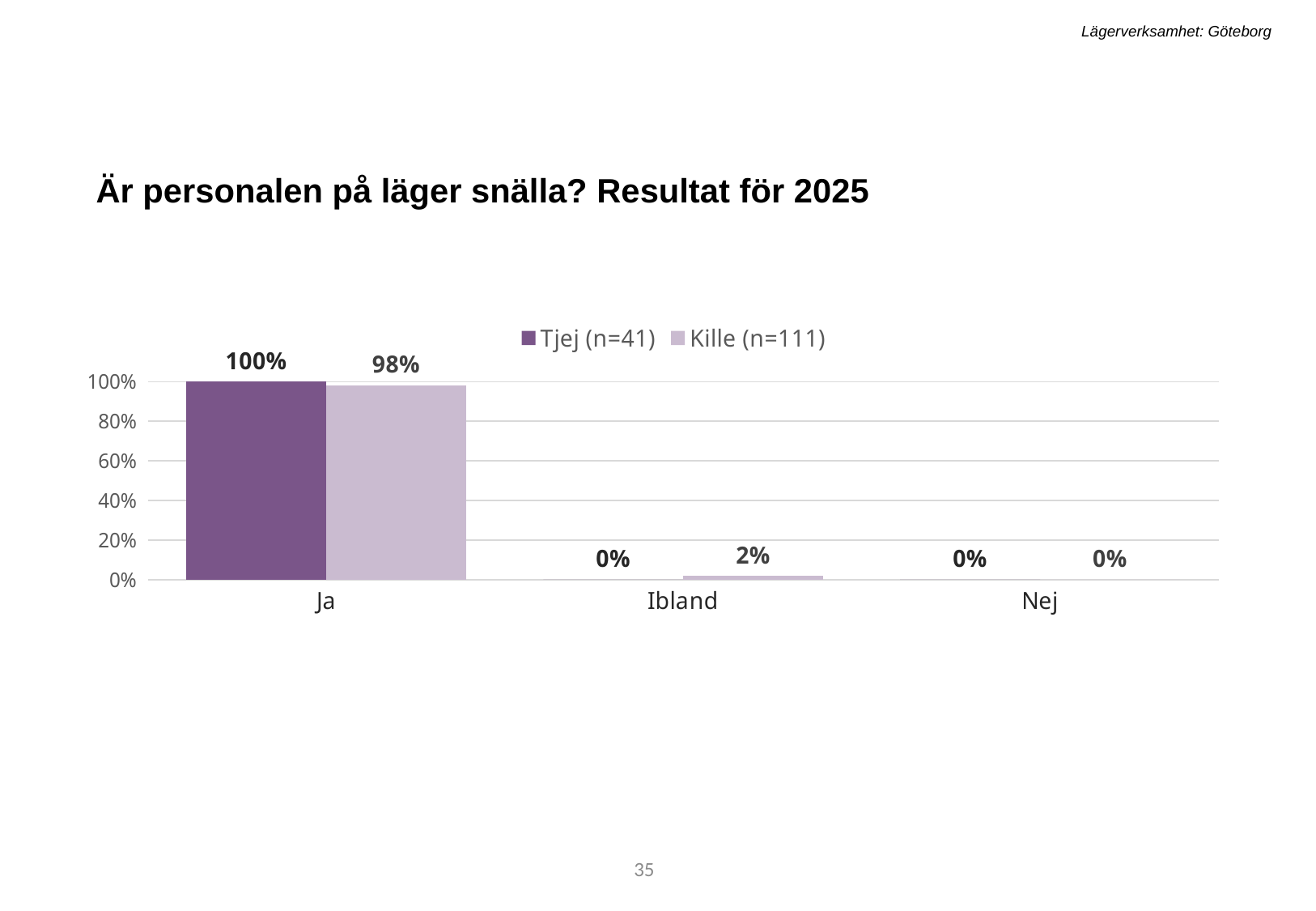
How many series does the legend list? 2 Is the value for Kille (n=111) in the Ja category greater or less than 80%? greater What is the value for Tjej (n=41) in the Nej category? 0% How many categories are shown on the x axis? 3 What is the difference between the Tjej (n=41) and Kille (n=111) values in the Ja category? 2% Which is larger in the Ibland category, Tjej (n=41) or Kille (n=111)? Kille (n=111) What is the value for Kille (n=111) in the Ibland category? 2% What kind of chart is shown on the slide? Bar chart What is the value for Tjej (n=41) in the Ja category? 100% What is the value for Kille (n=111) in the Ja category? 98% What is the title of the chart on the slide? Är personalen på läger snälla? Resultat för 2025 Which category has the highest value for Kille (n=111)? Ja